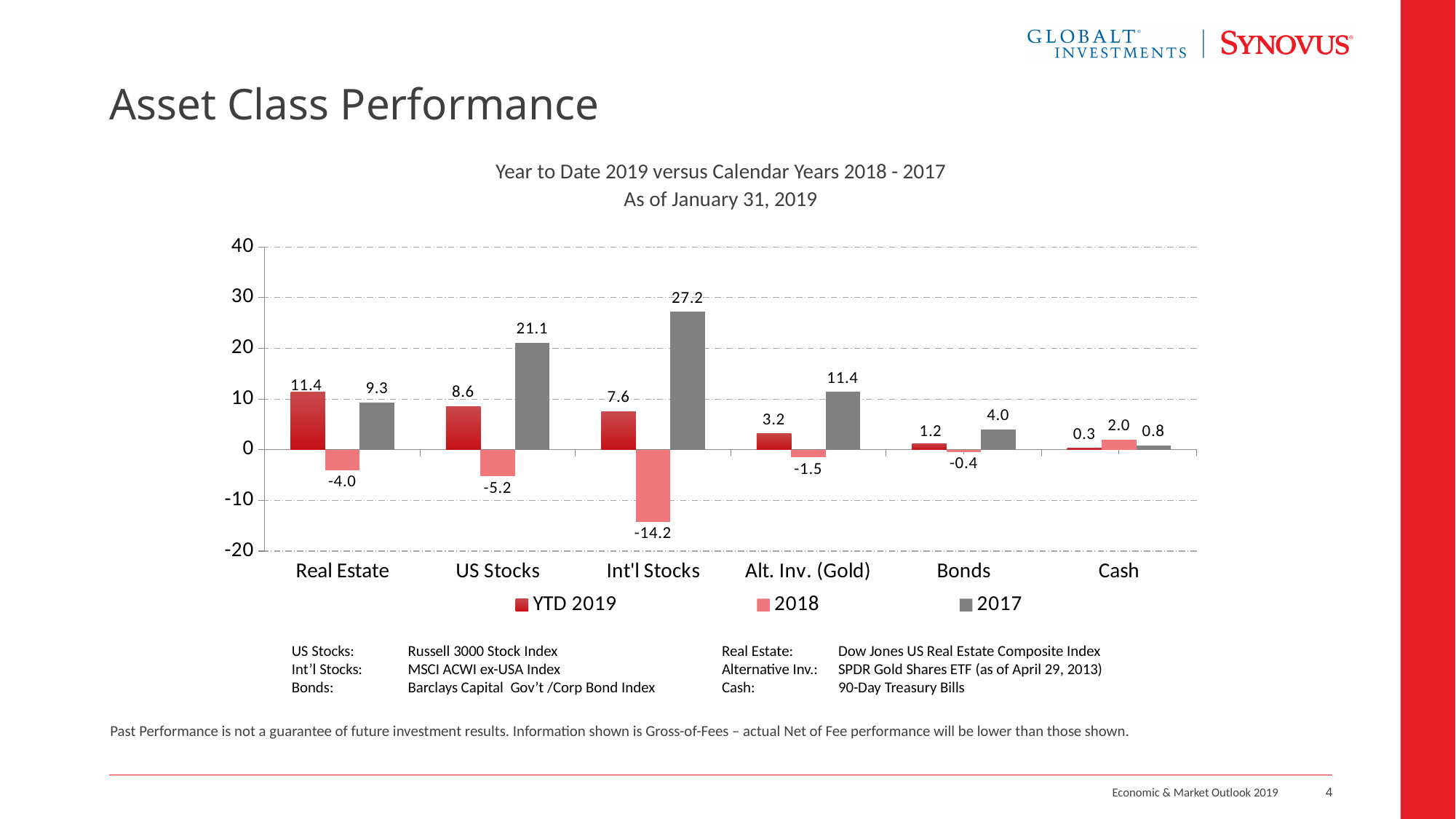
Which asset class has the highest 2017 value? Int'l Stocks Which asset class has the lowest 2018 value? Int'l Stocks Which is larger for Alt. Inv. (Gold): the YTD 2019 value or the 2017 value? 2017 How many asset classes are shown on the x axis? 6 What kind of chart is shown on the slide? Bar chart How many series does the legend list? 3 What is the 2017 value for US Stocks? 21.1 What is the 2018 value for Cash? 2.0 What is the chart's subtitle date line? As of January 31, 2019 What is the difference between the 2017 and YTD 2019 values for Int'l Stocks? 19.6 What is the YTD 2019 value for Real Estate? 11.4 What is the 2018 value for Int'l Stocks? -14.2